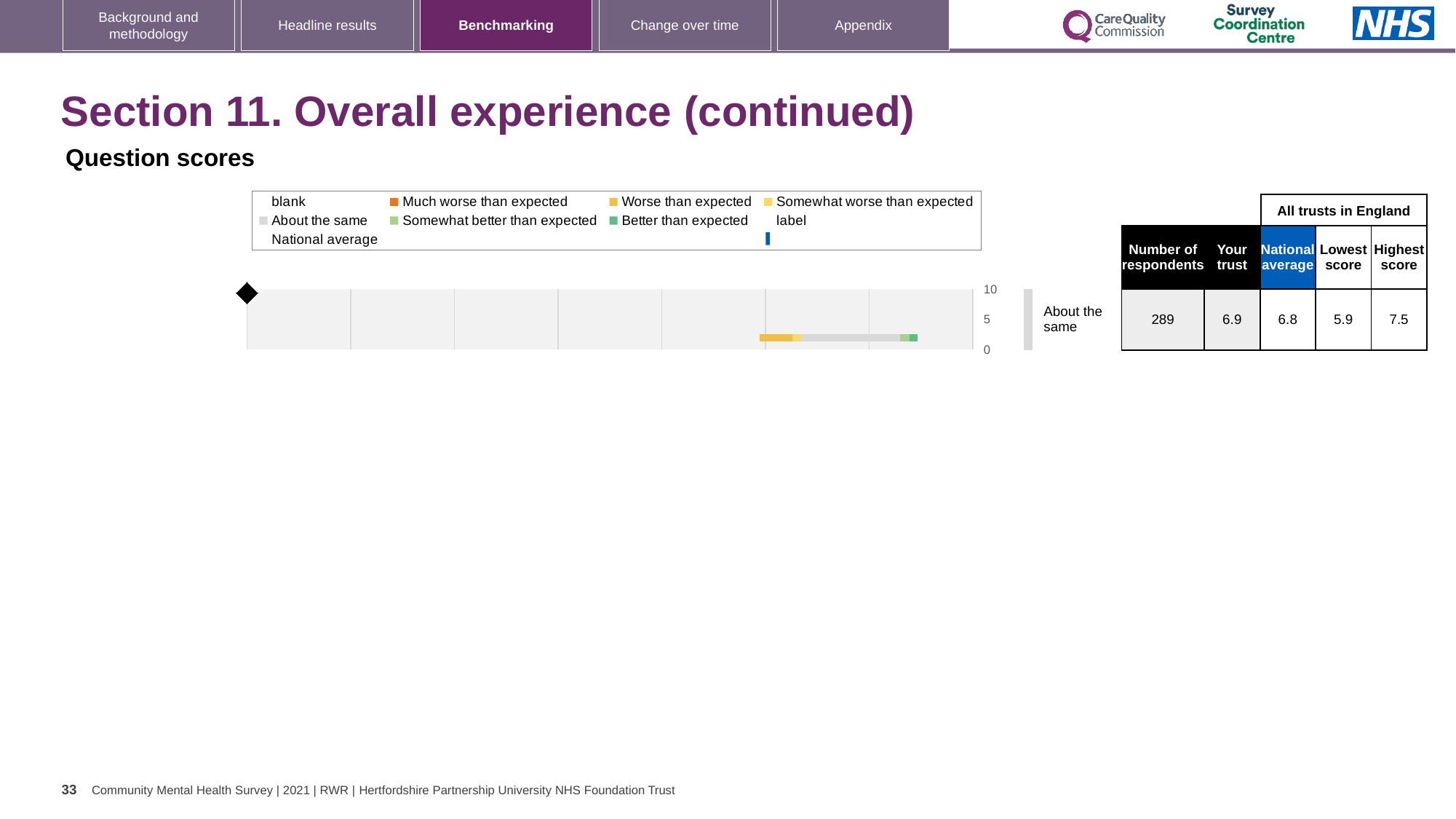
What is the national average score for the 'About the same' row? 6.8 What is the highest score among all trusts in England for the 'About the same' row? 7.5 Which is larger for the 'About the same' row: the 'Your trust' score or the national average? Your trust How many question rows are plotted in the chart? 1 What is the highest value shown on the chart's score axis? 10 What is the 'Your trust' score for the 'About the same' row? 6.9 What kind of chart is shown on the slide? bar chart How many respondents are recorded for the 'About the same' row? 289 What is the difference between the highest score and the lowest score for the 'About the same' row? 1.6 What colour represents 'Better than expected' in the chart legend? green What is the lowest score among all trusts in England for the 'About the same' row? 5.9 How many entries does the chart legend list? 9